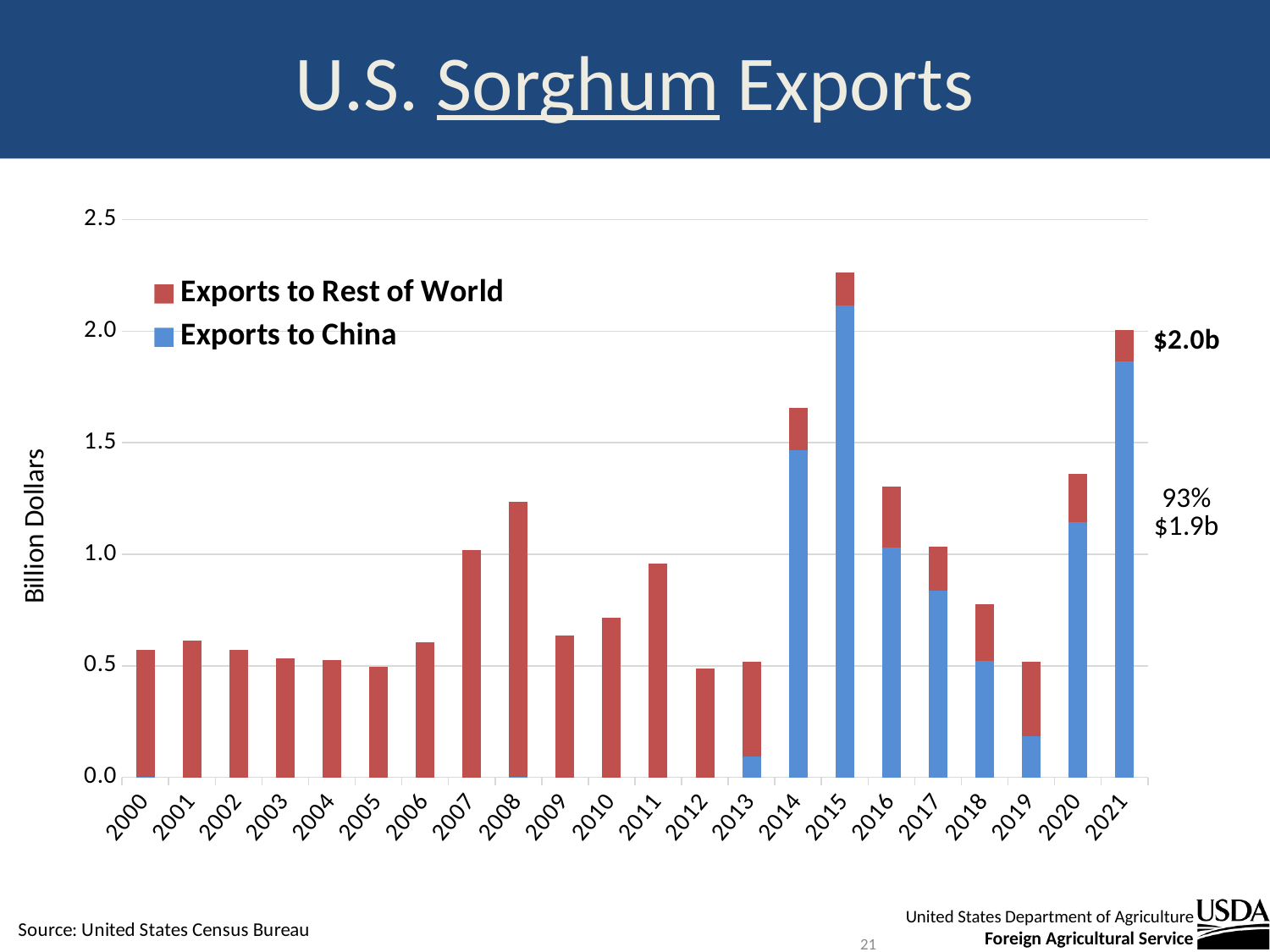
What is the labeled total value of U.S. sorghum exports in 2021? $2.0b Which year has the highest total sorghum exports? 2015 What is the label on the y axis? Billion Dollars How many series does the legend list? 2 Is the total value for 2015 greater or less than 2.0? greater What kind of chart is shown on the slide? bar chart Do total exports rise or fall from 2015 to 2019? fall What is the labeled value of exports to China in 2021? $1.9b How many years are shown on the x axis? 22 Which year has a larger total bar, 2008 or 2007? 2008 What percentage of 2021 sorghum exports went to China, according to the label? 93% Is the total value for 2014 greater or less than 1.5? greater